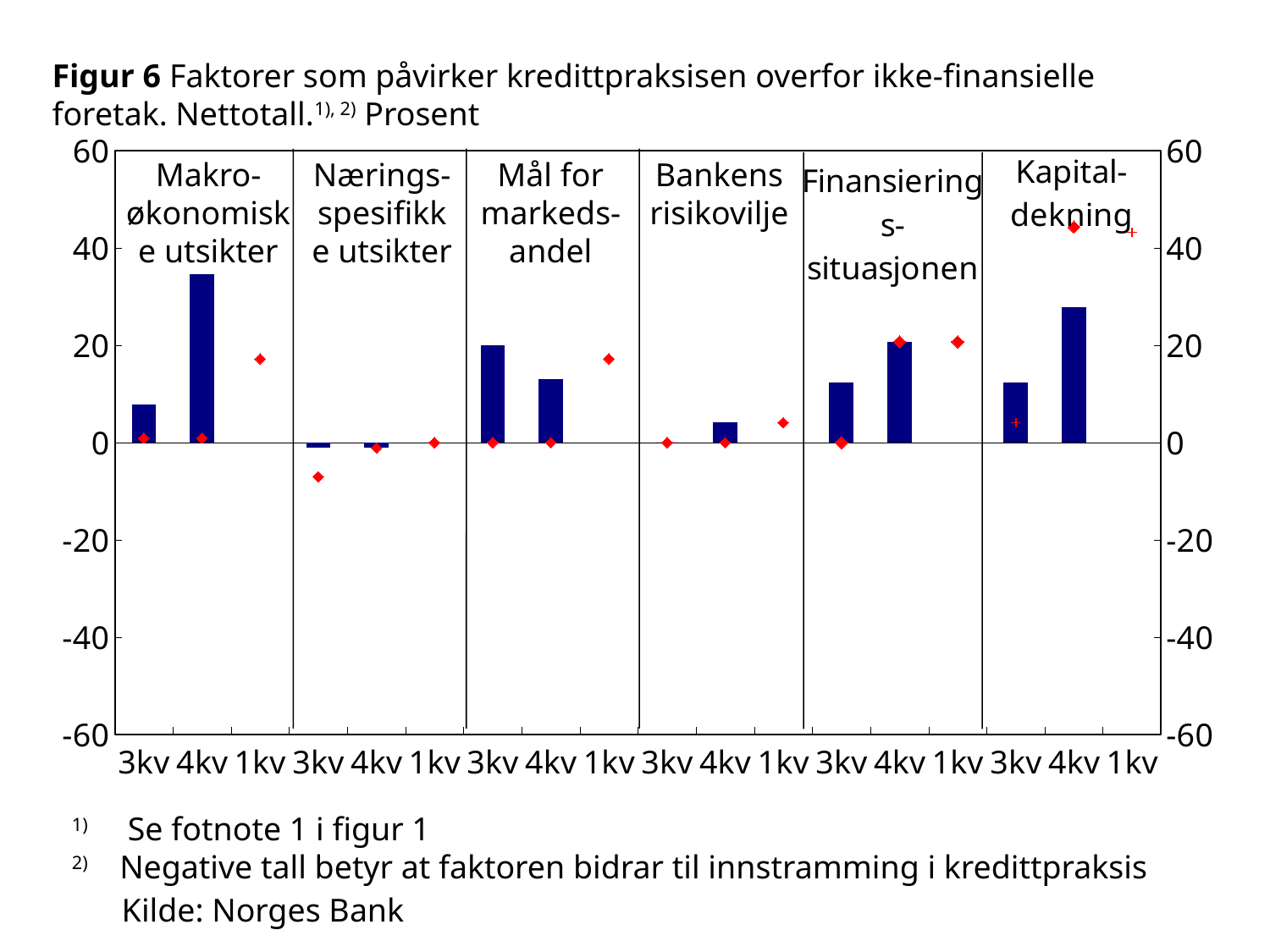
What source is cited below the chart? Norges Bank What is the figure number given in the chart title? Figur 6 Which factor panel shows negative bars for both 3kv and 4kv? Næringsspesifikke utsikter Which is larger for Kapitaldekning, the 3kv bar or the 4kv bar? 4kv Which is larger for Mål for markedsandel, the 3kv bar or the 4kv bar? 3kv Is the 4kv bar for Makro-økonomiske utsikter greater or less than 40? less Is the 4kv bar for Makro-økonomiske utsikter greater or less than 20? greater How many factor panels does the chart have? 6 Is the 3kv bar for Finansieringssituasjonen greater or less than 20? less Which factor panel has the tallest bar in the chart? Makro-økonomiske utsikter What kind of chart is shown on the slide? bar chart